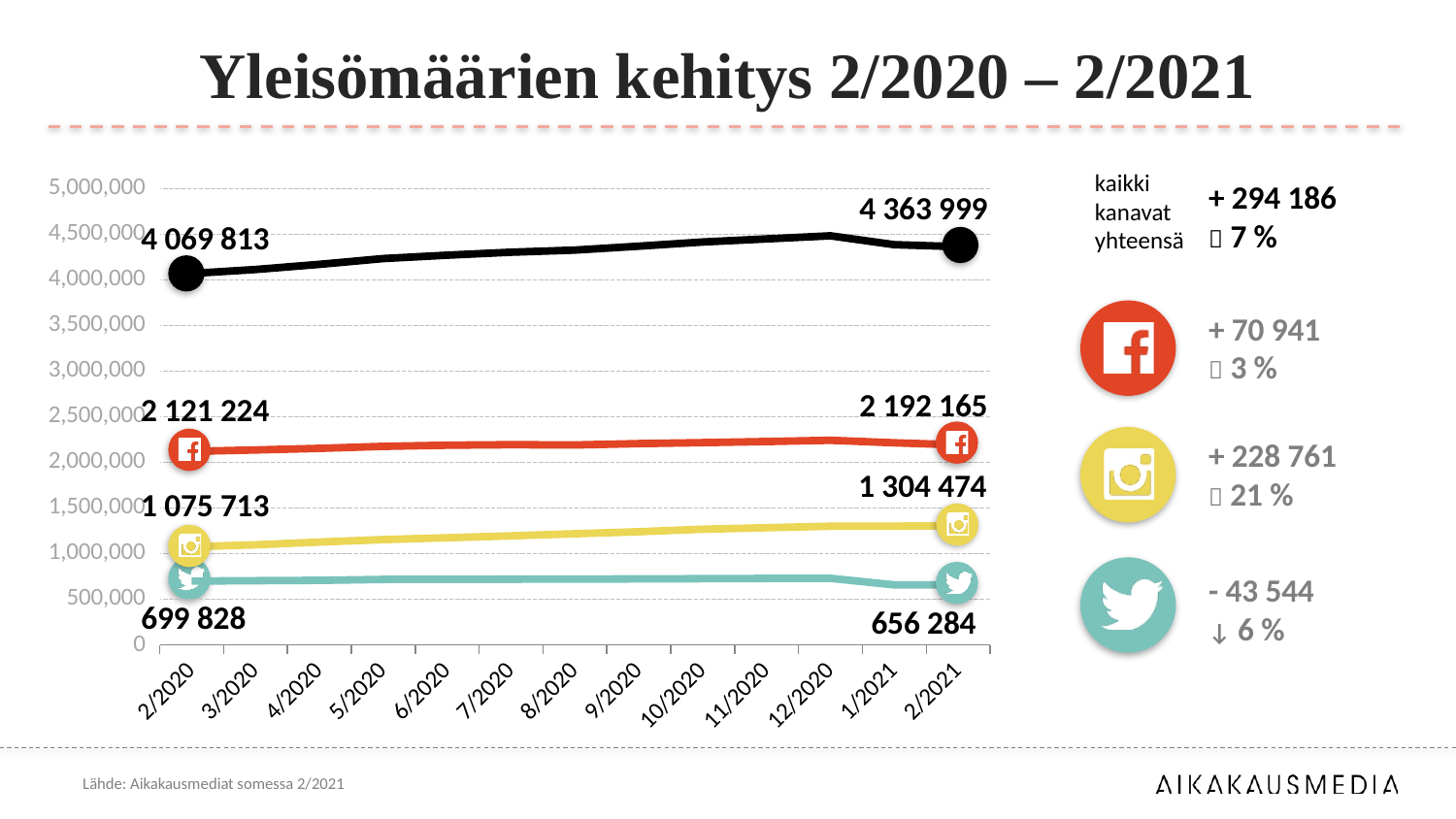
By how much did the Instagram (yellow) line change from 2/2020 to 2/2021? 228 761 Is the Facebook (red) line's value at 8/2020 greater or less than 2,000,000? greater Does the Twitter (teal) line rise or fall from 2/2020 to 2/2021? Fall What is the value of the black (total) line at 2/2020? 4 069 813 How many time points are shown on the x axis? 13 What is the Instagram (yellow) line's value at 2/2020? 1 075 713 At 2/2021, which is larger: the Facebook (red) line or the Instagram (yellow) line? Facebook What is the Facebook (red) line's value at 2/2021? 2 192 165 What kind of chart is shown on the slide? Line chart What is the Twitter (teal) line's value at 2/2021? 656 284 By how much did the Twitter (teal) line decrease from 2/2020 (699 828) to 2/2021 (656 284)? 43 544 What is the value of the black (total) line at 2/2021? 4 363 999